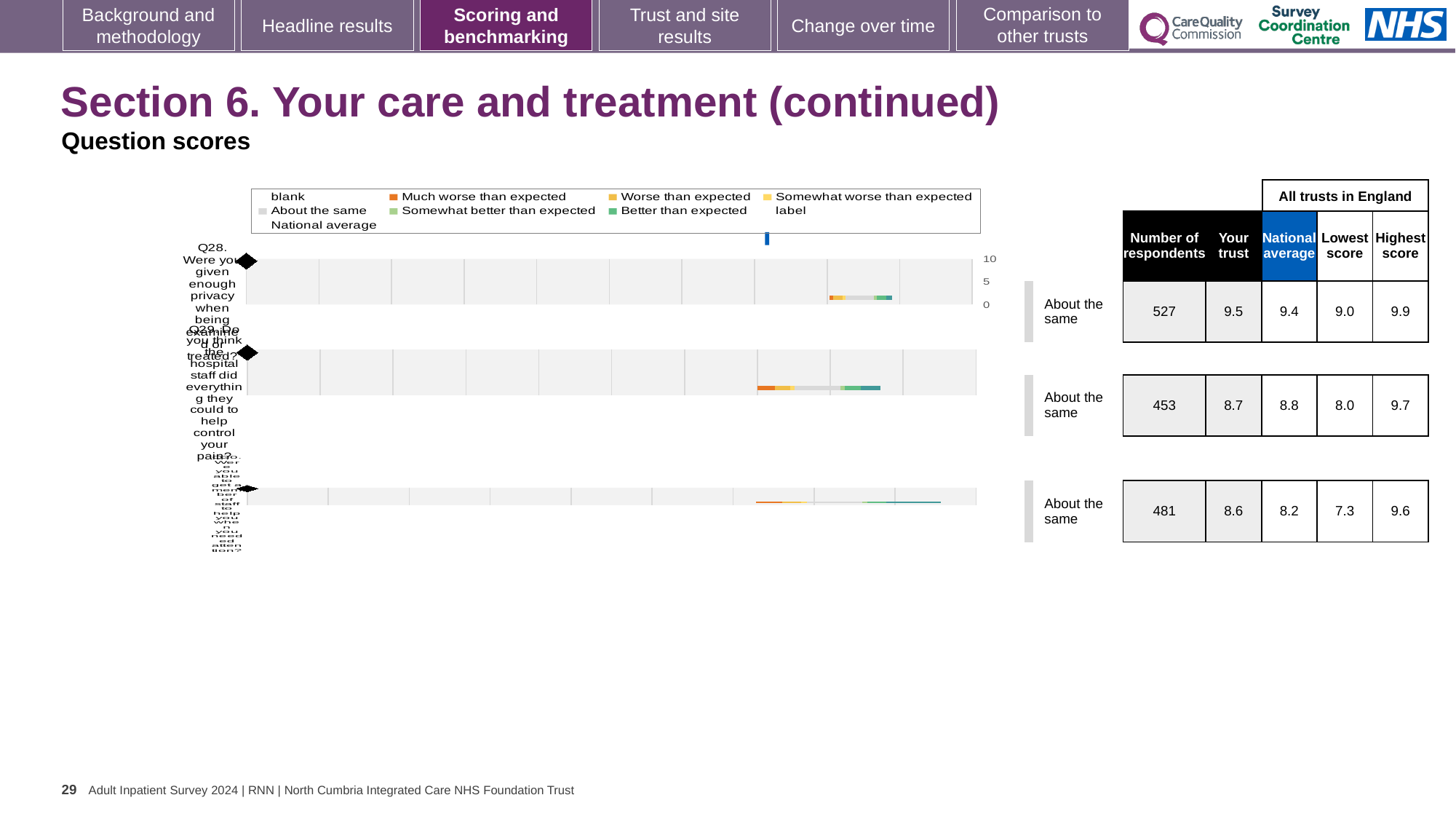
What benchmark category label is shown next to the chart for Q29? About the same What is the difference between the 'Your trust' score and the national average for Q30? 0.4 For Q30, is the 'Your trust' score larger or smaller than the national average? larger Which of the three questions (Q28, Q29, Q30) has the highest 'Your trust' score? Q28 What is the maximum value shown on the score axis of the charts? 10 What is the highest score across all trusts in England shown for Q28? 9.9 What is the number of respondents shown for Q30 (Were you able to get a member of staff to help you when you needed attention?)? 481 What is the lowest score across all trusts in England shown for Q30? 7.3 What is the 'Your trust' score shown for Q28 (Were you given enough privacy when being examined or treated?)? 9.5 Which of the three questions (Q28, Q29, Q30) has the lowest national average score? Q30 What is the national average score shown for Q29 (Do you think the hospital staff did everything they could to help control your pain?)? 8.8 What colour does the legend use for 'Much worse than expected'? Orange